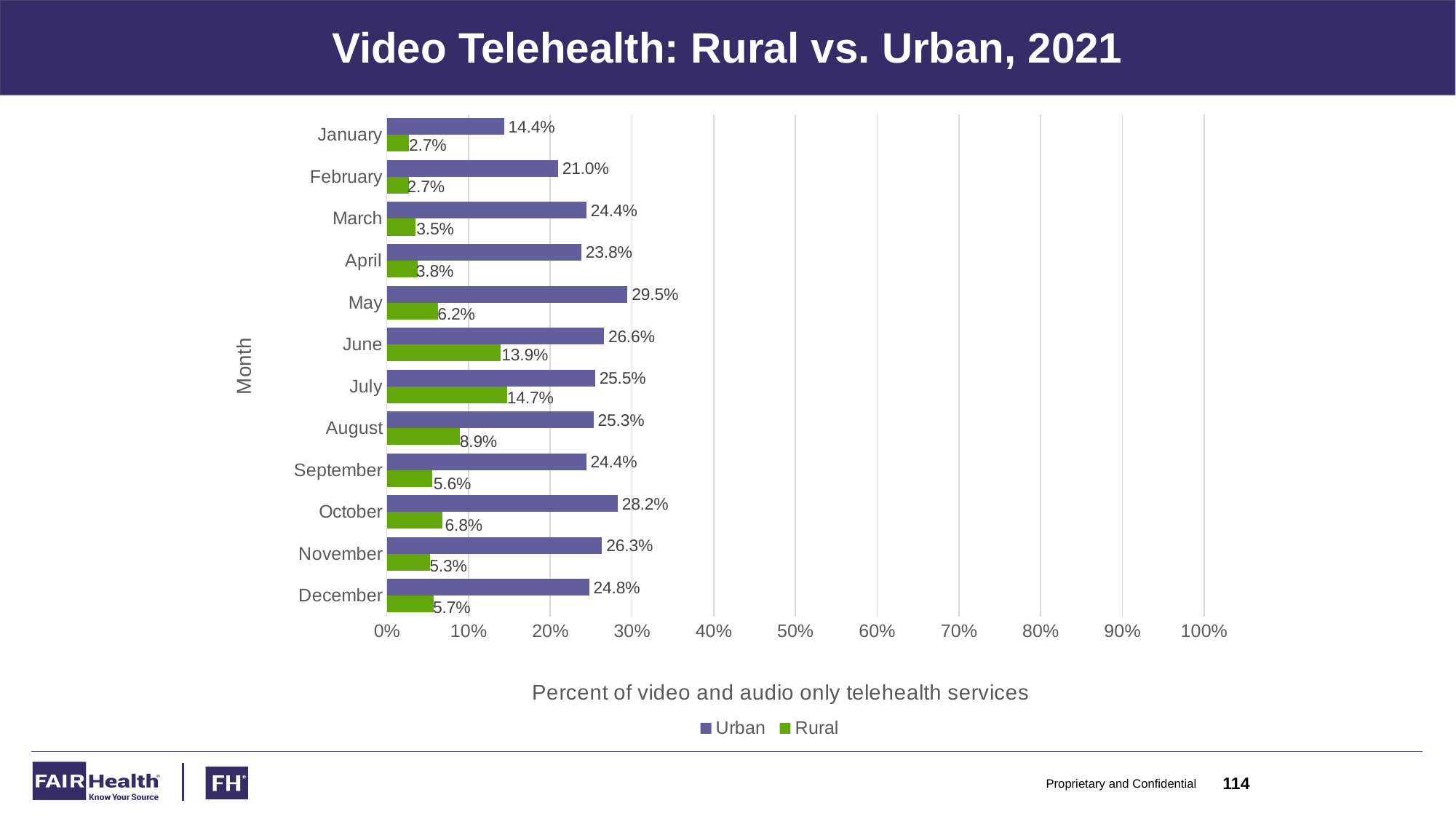
Is the Urban value for February greater or less than 20%? greater What is the Rural value for August? 8.9% Which month has the lowest Urban value? January What is the difference between the Urban and Rural values for June? 12.7 percentage points What is the Rural value for July? 14.7% Which month has the highest Urban value? May What is the Urban value for May? 29.5% Which is larger, the Urban value for October or the Urban value for November? October How many months are shown on the chart? 12 What kind of chart is shown on the slide? Bar chart How many series does the legend list? 2 Which month has the highest Rural value? July